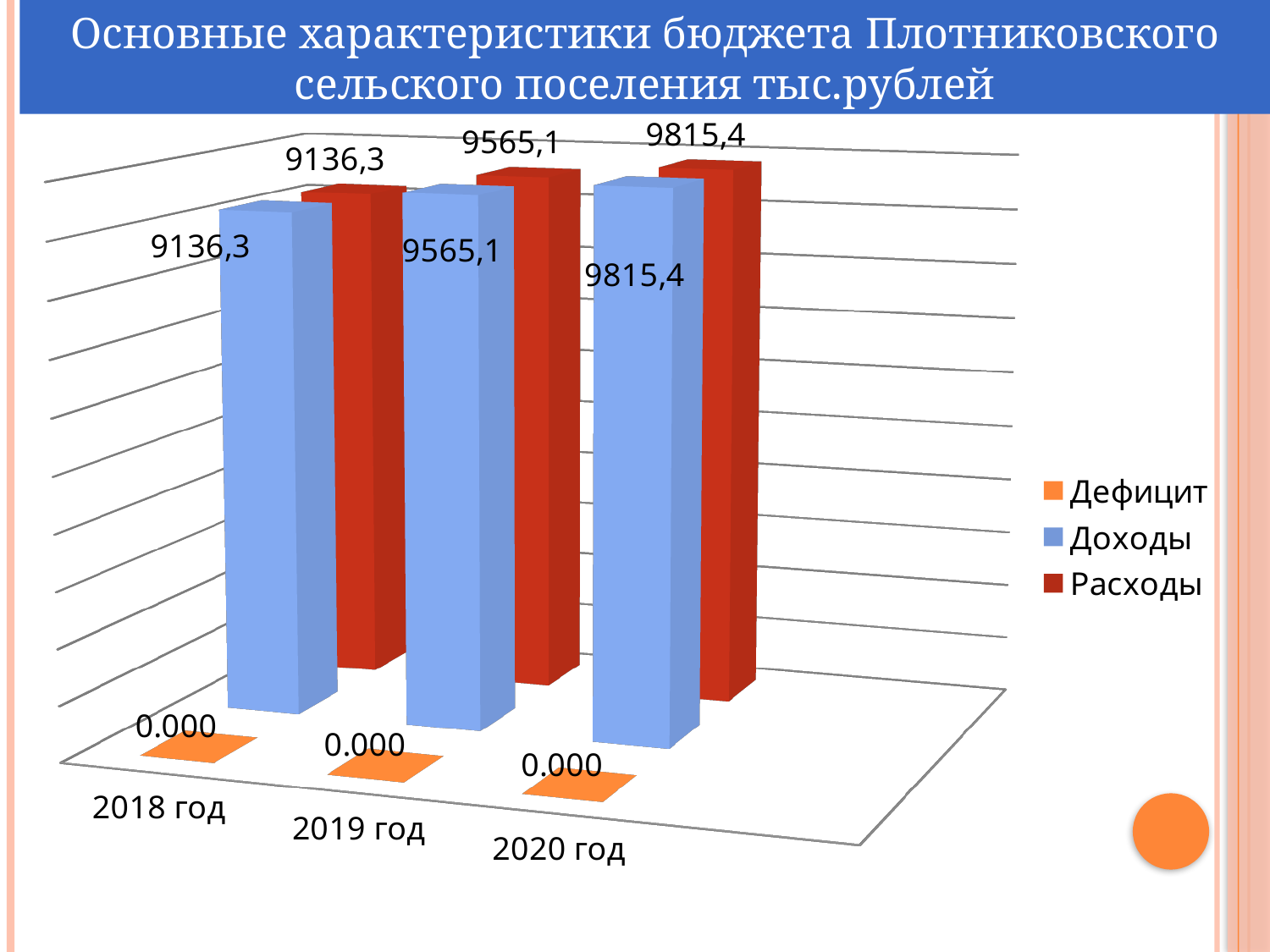
In which year is Расходы lowest? 2018 год What type of chart is shown on the slide? Bar chart Which series is shown in orange in the legend? Дефицит What is the difference between Доходы in 2020 год and Доходы in 2018 год? 679,1 Do the Расходы values rise or fall from 2018 год to 2020 год? Rise What is the value of Расходы for 2020 год? 9815,4 What is the value of Доходы for 2019 год? 9565,1 How many year categories are shown on the x axis? 3 How many series does the legend list? 3 What is the value of Дефицит for 2019 год? 0.000 In which year is Доходы highest? 2020 год What is the value of Доходы for 2018 год? 9136,3